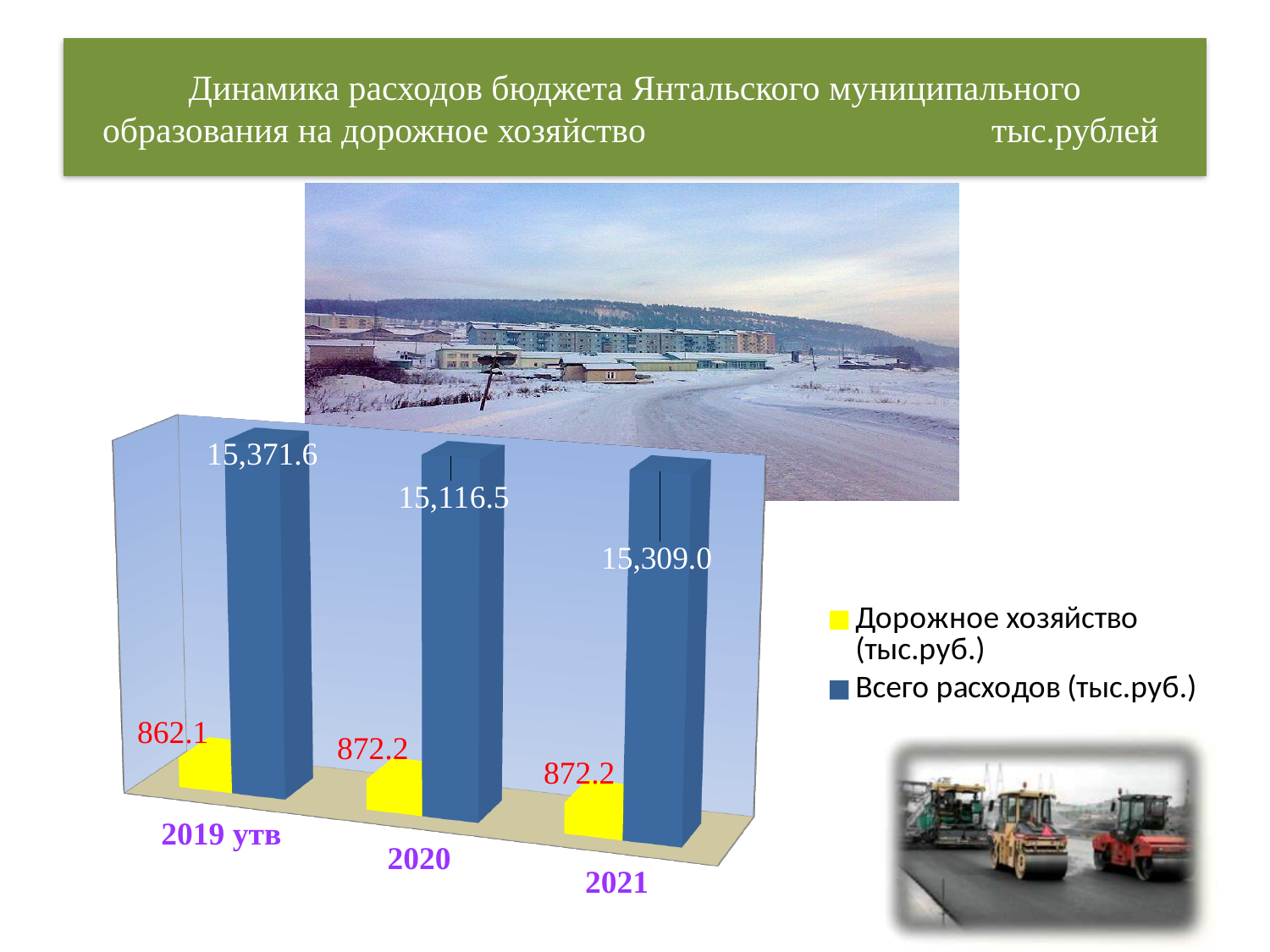
What is the difference between Дорожное хозяйство (тыс.руб.) in 2020 and in 2019 утв? 10.1 Which is larger: Всего расходов (тыс.руб.) in 2021 or in 2020? 2021 What is the difference between Всего расходов (тыс.руб.) in 2019 утв and in 2020? 255.1 How many series does the legend list? 2 How many years are shown on the x axis of the chart? 3 What is the value of Дорожное хозяйство (тыс.руб.) for 2019 утв? 862.1 What is the value of Дорожное хозяйство (тыс.руб.) for 2020? 872.2 In which year is Всего расходов (тыс.руб.) the lowest? 2020 In which year is Дорожное хозяйство (тыс.руб.) the lowest? 2019 утв In which year is Всего расходов (тыс.руб.) the highest? 2019 утв What is the value of Всего расходов (тыс.руб.) for 2019 утв? 15,371.6 What is the value of Всего расходов (тыс.руб.) for 2021? 15,309.0